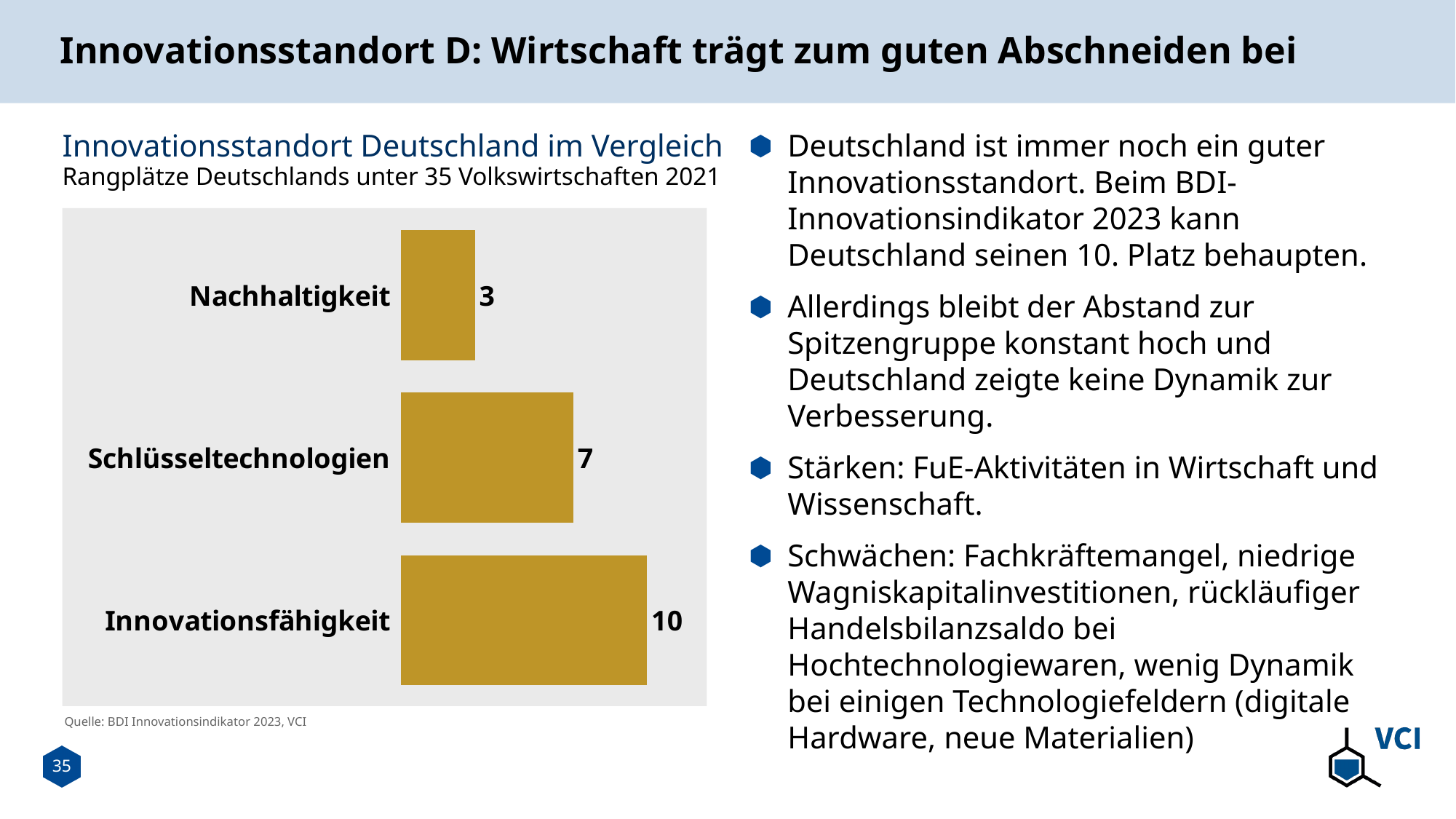
Which has the larger value, Schlüsseltechnologien or Innovationsfähigkeit? Innovationsfähigkeit What is the source given below the chart? BDI Innovationsindikator 2023, VCI What is the difference between the values for Innovationsfähigkeit and Nachhaltigkeit? 7 What is the title of the chart? Innovationsstandort Deutschland im Vergleich What is the difference between the values for Schlüsseltechnologien and Nachhaltigkeit? 4 What kind of chart is shown on the slide? Bar chart What rank does Germany hold for Schlüsseltechnologien? 7 What rank does Germany hold for Nachhaltigkeit? 3 What rank does Germany hold for Innovationsfähigkeit? 10 How many categories are shown in the chart? 3 Which category has the highest value in the chart? Innovationsfähigkeit Which category has the lowest value in the chart? Nachhaltigkeit